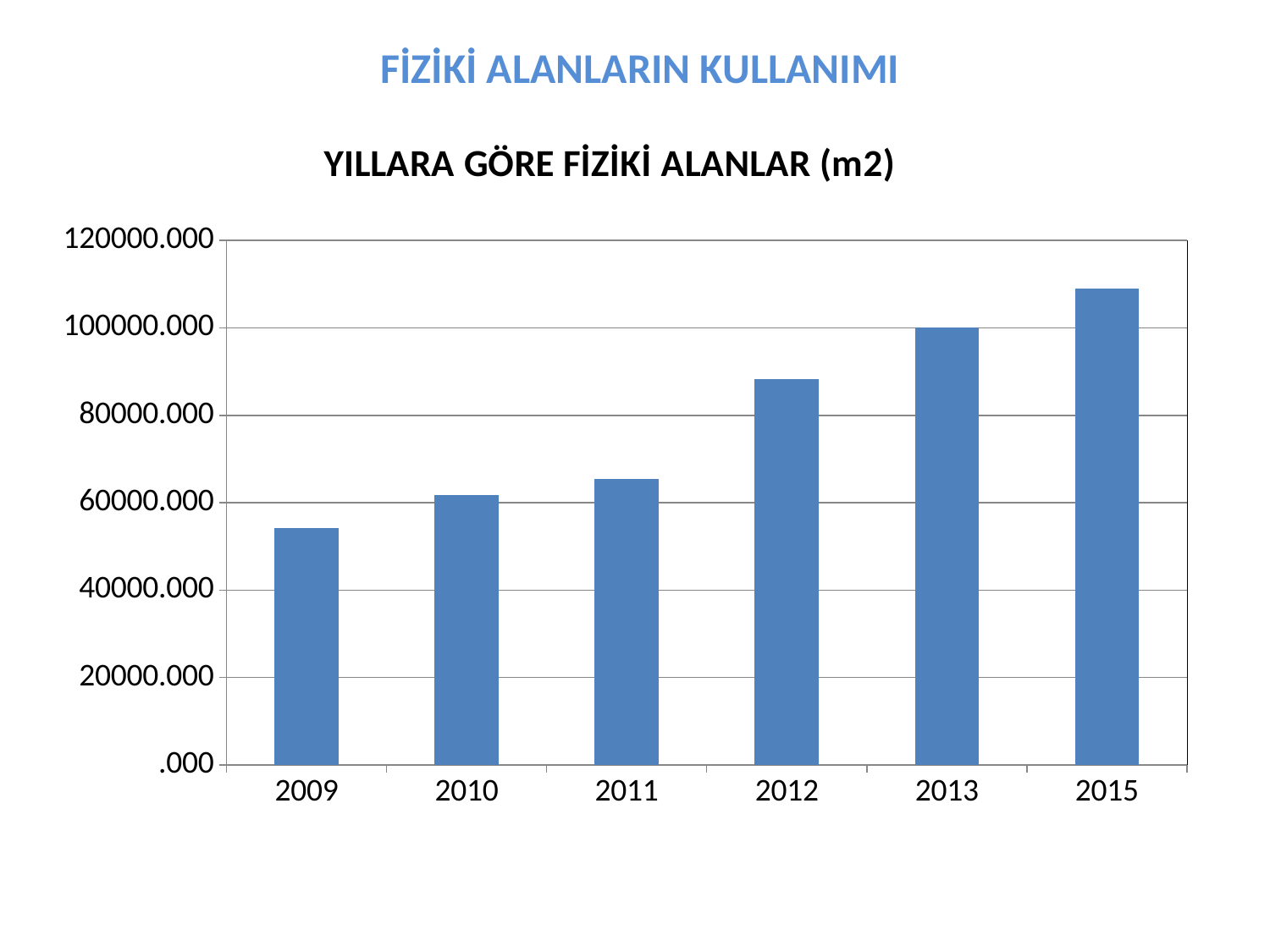
What is the title of the chart? YILLARA GÖRE FİZİKİ ALANLAR (m2) Is the value for 2015 greater or less than 100000.000? greater What kind of chart is shown on the slide? bar chart Is the value for 2011 greater or less than 80000.000? less Do the values rise or fall from 2009 to 2015 along the x axis? rise Which year has the highest value in the chart? 2015 Is the value for 2009 greater or less than 60000.000? less How many years are shown on the x axis of the chart? 6 Which year has the lowest value in the chart? 2009 Which is larger, the value for 2012 or the value for 2011? 2012 Which is larger, the value for 2010 or the value for 2013? 2013